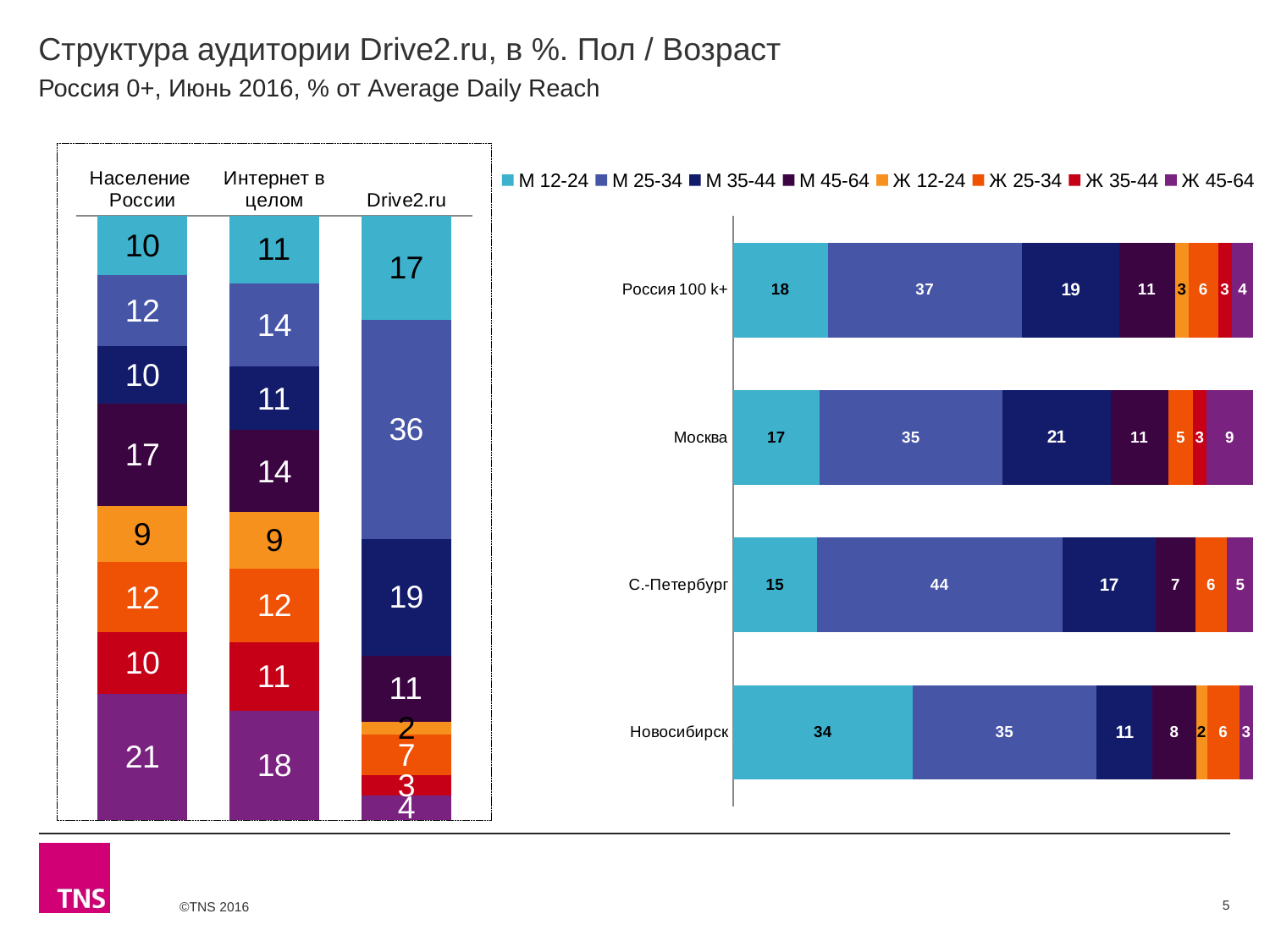
How many categories (bars) are shown in the right horizontal bar chart? 4 In the left stacked bar chart, which segment is the largest in the Drive2.ru bar? М 25-34 In the left stacked bar chart, which segment is the smallest in the Drive2.ru bar? Ж 12-24 How many series does the legend list? 8 In the left stacked bar chart, what is the difference between the М 25-34 values for Drive2.ru and Население России? 24 In the right horizontal bar chart, which city has the largest М 12-24 segment? Новосибирск In the right horizontal bar chart, what is the value of the М 12-24 segment for Новосибирск? 34 In the left stacked bar chart, what is the value of the Ж 45-64 segment for Население России? 21 In the right horizontal bar chart, what is the value of the М 25-34 segment for С.-Петербург? 44 In the right horizontal bar chart, is the М 35-44 value larger for Москва or for Россия 100 k+? Москва In the left stacked bar chart, what is the value of the М 45-64 segment for Интернет в целом? 14 In the left stacked bar chart, what is the value of the М 25-34 segment for Drive2.ru? 36